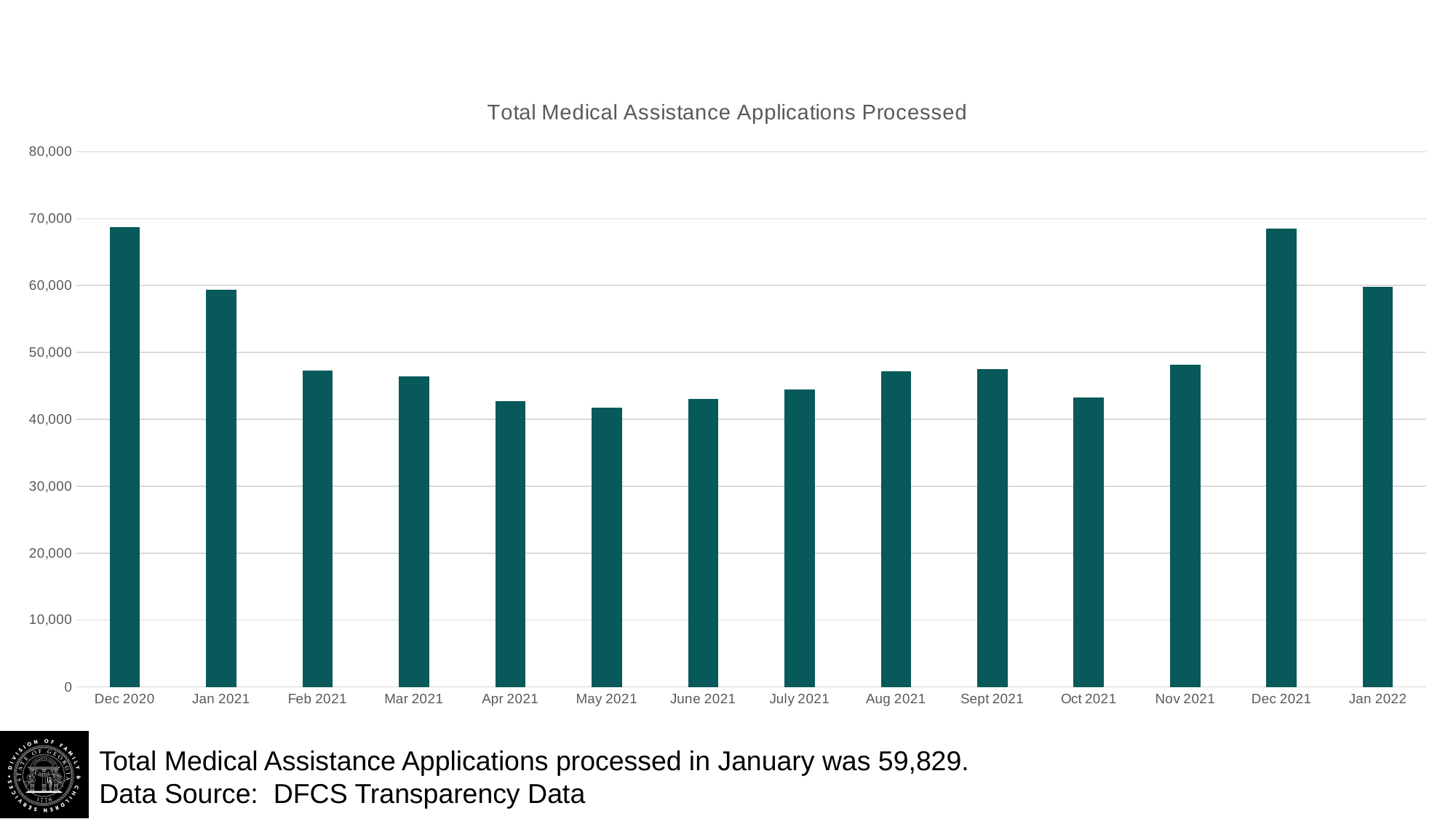
Which is larger, the value for Dec 2020 or the value for May 2021? Dec 2020 According to the slide text, how many Total Medical Assistance Applications were processed in January? 59,829 What kind of chart is shown on the slide? bar chart Is the value for Dec 2020 greater or less than 60,000? greater What is the title of the chart? Total Medical Assistance Applications Processed How many months are shown on the x axis of the chart? 14 Is the value for Nov 2021 greater or less than 50,000? less Is the value for Dec 2021 greater or less than 60,000? greater What data source is cited on the slide? DFCS Transparency Data Do the values rise or fall from Dec 2020 to May 2021? fall Which is larger, the value for Nov 2021 or the value for Oct 2021? Nov 2021